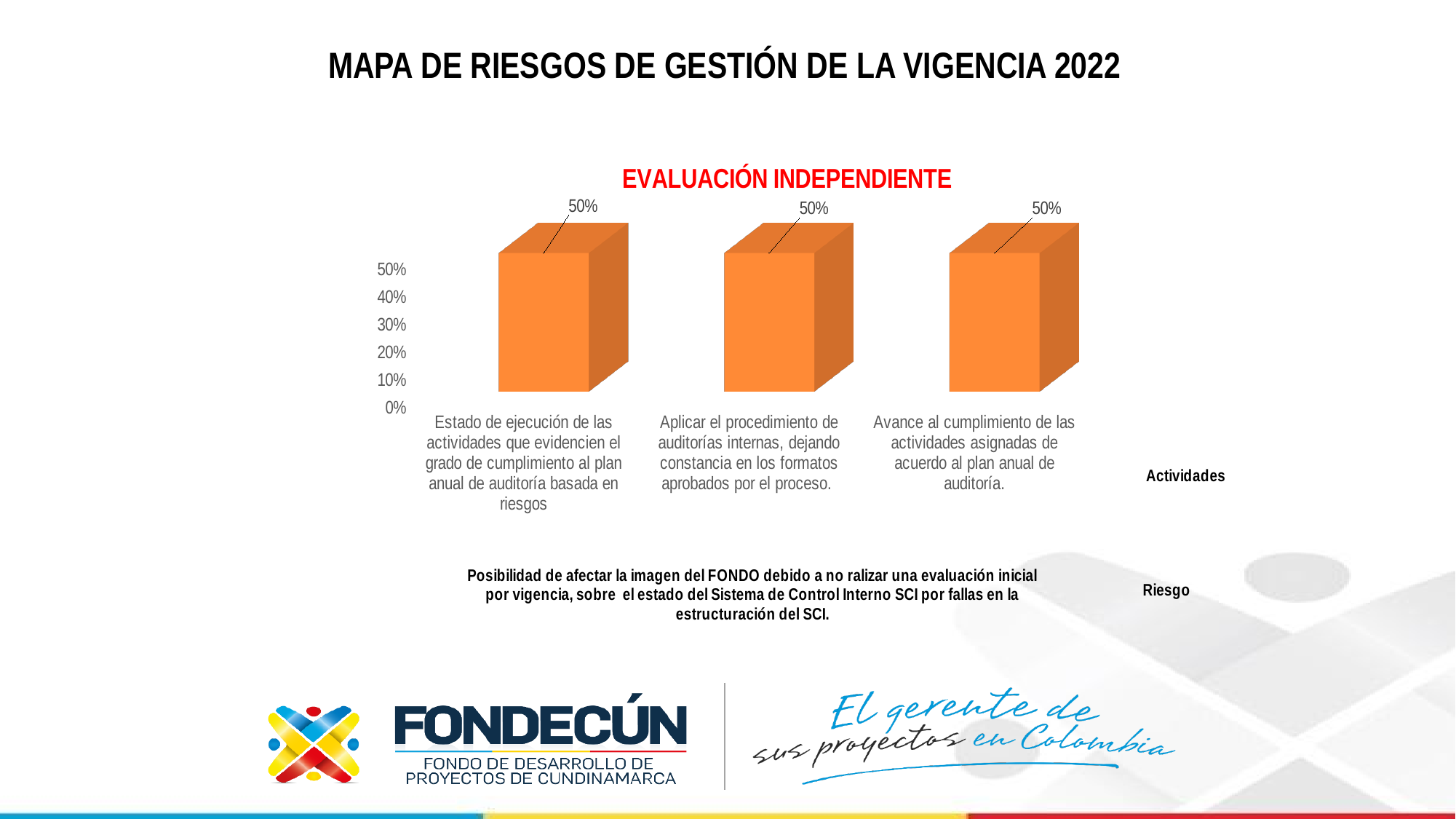
What is the value for "Avance al cumplimiento de las actividades asignadas de acuerdo al plan anual de auditoría."? 50% What kind of chart is shown on the slide? Bar chart How many categories are plotted in the chart? 3 What is the title of the chart? EVALUACIÓN INDEPENDIENTE What is the value for "Estado de ejecución de las actividades que evidencien el grado de cumplimiento al plan anual de auditoría basada en riesgos"? 50% Is the value for "Aplicar el procedimiento de auditorías internas..." greater or less than 40%? greater What is the highest tick label shown on the vertical axis? 50% What is the difference between the value for "Estado de ejecución de las actividades..." and the value for "Avance al cumplimiento de las actividades asignadas..."? 0% What colour are the bars in the chart? Orange What is the value for "Aplicar el procedimiento de auditorías internas, dejando constancia en los formatos aprobados por el proceso."? 50% Do the values rise, fall, or stay the same across the categories from left to right? Stay the same Is the value for "Avance al cumplimiento de las actividades asignadas..." greater or less than 30%? greater